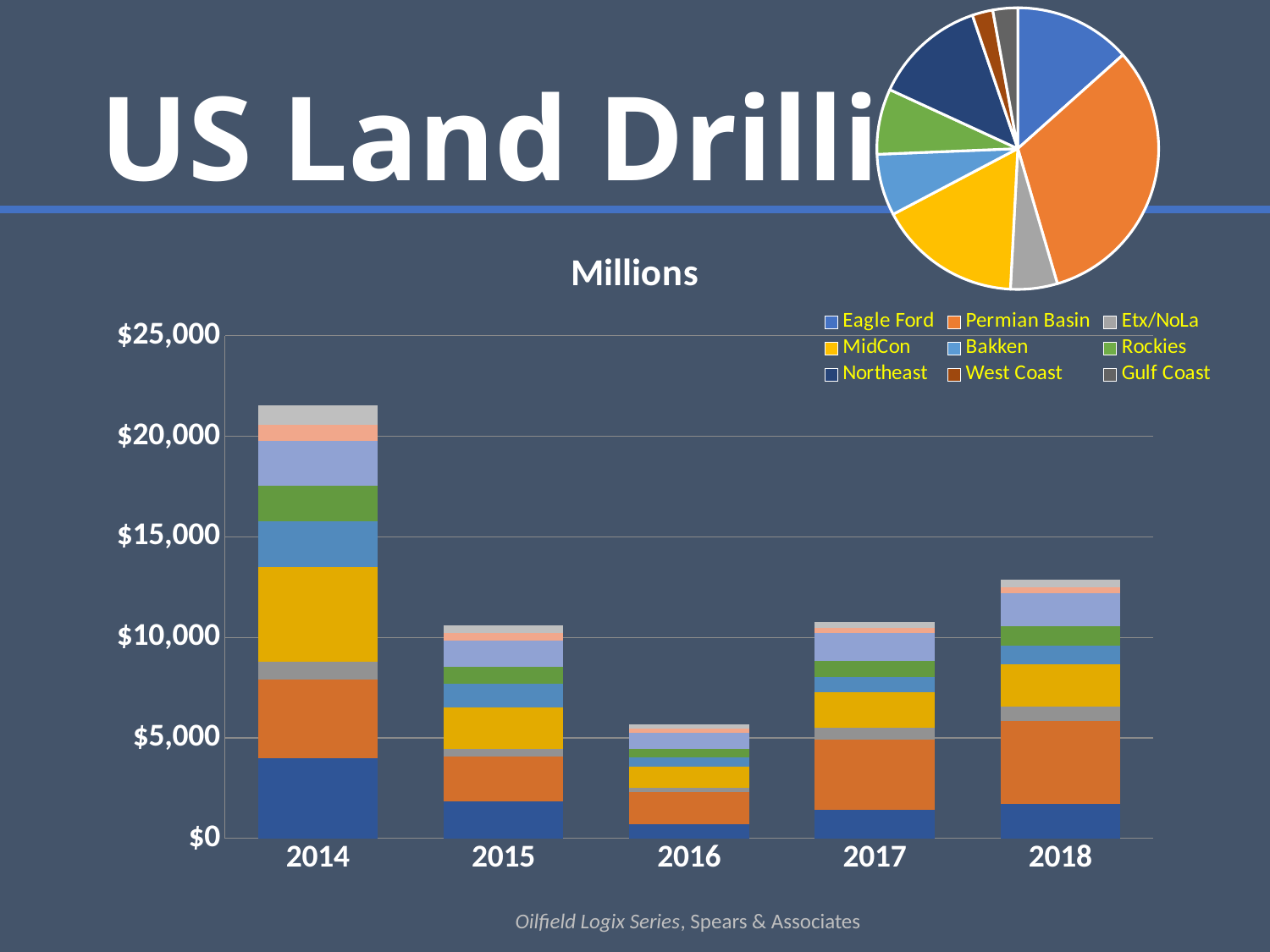
In the 'Millions' chart, is the total for 2018 greater or less than $10,000? greater In the 'Millions' chart, is the total for 2016 greater or less than $10,000? less In the 'Millions' chart, which bar is taller, 2014 or 2018? 2014 In the 'Millions' chart, is the total for 2014 greater or less than $20,000? greater What kind of chart is the 'Millions' chart at the bottom of the slide? Stacked bar chart In the 'Millions' chart, which year has the shortest stacked bar? 2016 In the 'Millions' chart, do the bar totals rise or fall from 2014 to 2016? Fall How many series does the legend of the 'Millions' chart list? 9 What kind of chart is shown in the top right corner of the slide? Pie chart In the 'Millions' chart, which year has the tallest stacked bar? 2014 How many years are shown on the x axis of the 'Millions' chart? 5